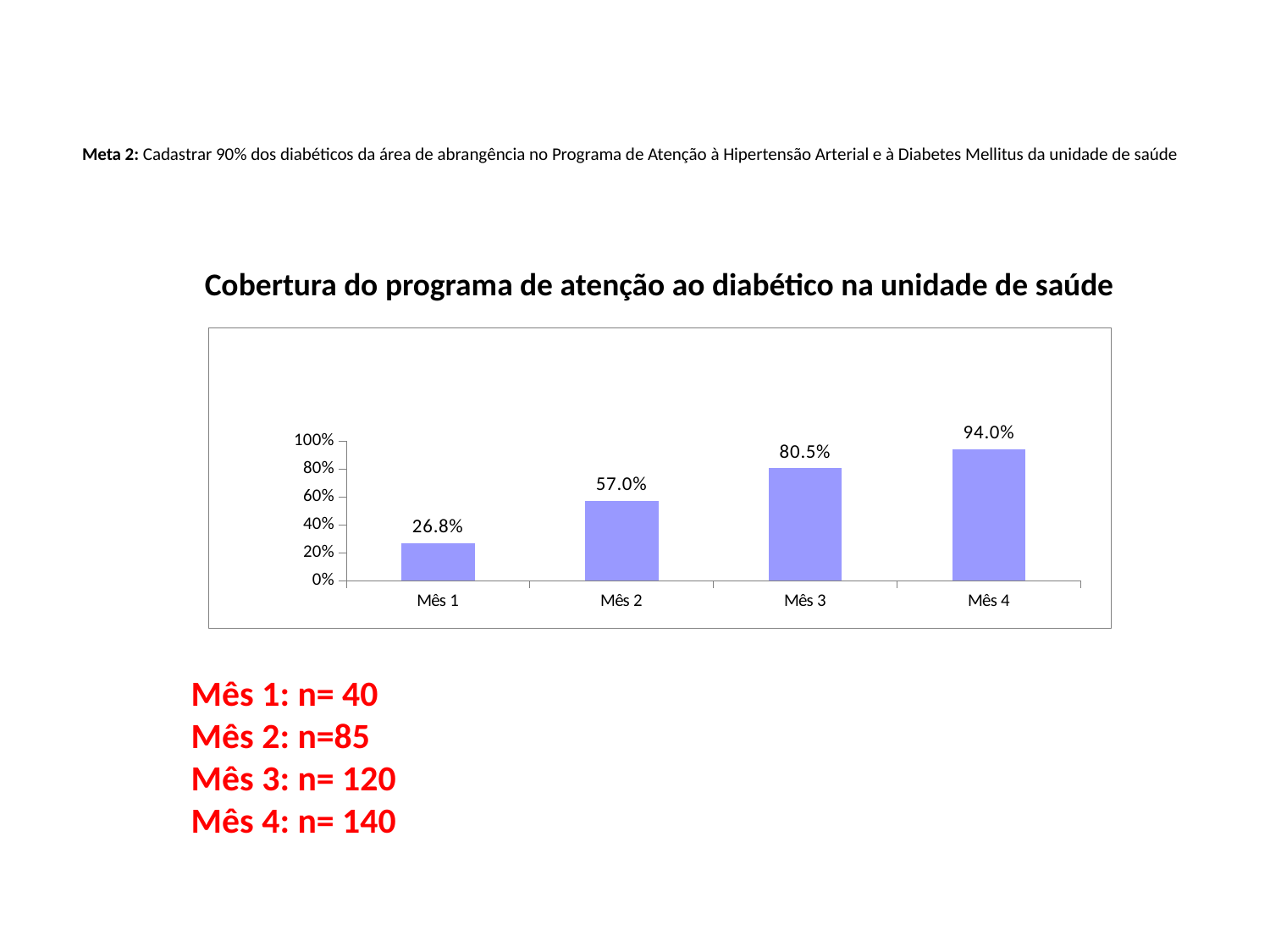
What is the difference between the values for Mês 4 and Mês 1? 67.2% Which month has the lowest value? Mês 1 Is the value for Mês 2 greater or less than 60%? less How many months are shown on the x axis? 4 What is the value for Mês 1? 26.8% Which month has the highest value? Mês 4 What is the value for Mês 4? 94.0% What is the difference between the values for Mês 3 and Mês 2? 23.5% Do the values rise or fall from Mês 1 to Mês 4? rise What is the value for Mês 3? 80.5% What kind of chart is shown on the slide? bar chart Which is larger, the value for Mês 2 or the value for Mês 3? Mês 3